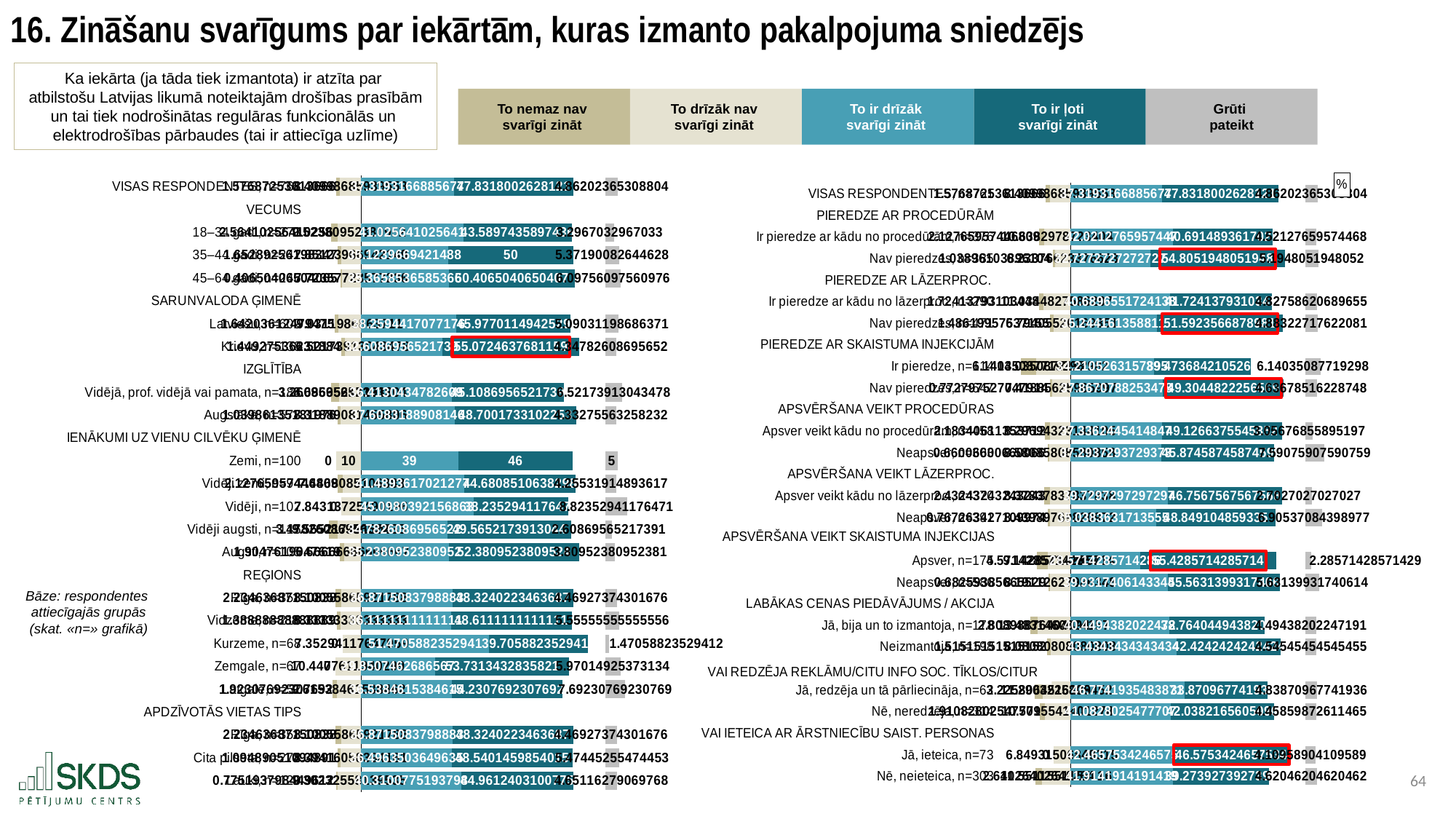
In the left chart, which series has the largest segment in the row 'Zemi, n=100'? To ir ļoti svarīgi zināt In the left chart, what is the value of 'To ir ļoti svarīgi zināt' for the row 'Zemi, n=100'? 46 Which legend entry is shown with the darkest teal colour? To ir ļoti svarīgi zināt In the right chart, what is the red-boxed value of 'To ir ļoti svarīgi zināt' for the row 'Jā, ieteica, n=73'? 46.5753424657534 In the left chart, what is the total of the stacked bar for the row 'Zemi, n=100'? 100 What kind of chart is used on this slide? bar chart In the right chart, what is the red-boxed value of 'To ir ļoti svarīgi zināt' for the row 'Apsver, n=175'? 55.4285714285714 In the left chart, what is the value of 'To ir drīzāk svarīgi zināt' for the row 'Zemi, n=100'? 39 In the left chart, what is the difference between 'To ir ļoti svarīgi zināt' and 'To ir drīzāk svarīgi zināt' for the row 'Zemi, n=100'? 7 In the left chart, what is the value of 'Grūti pateikt' for the row 'Zemi, n=100'? 5 In the left chart, what is the value of 'To nemaz nav svarīgi zināt' for the row 'Zemi, n=100'? 0 How many series does the legend list? 5